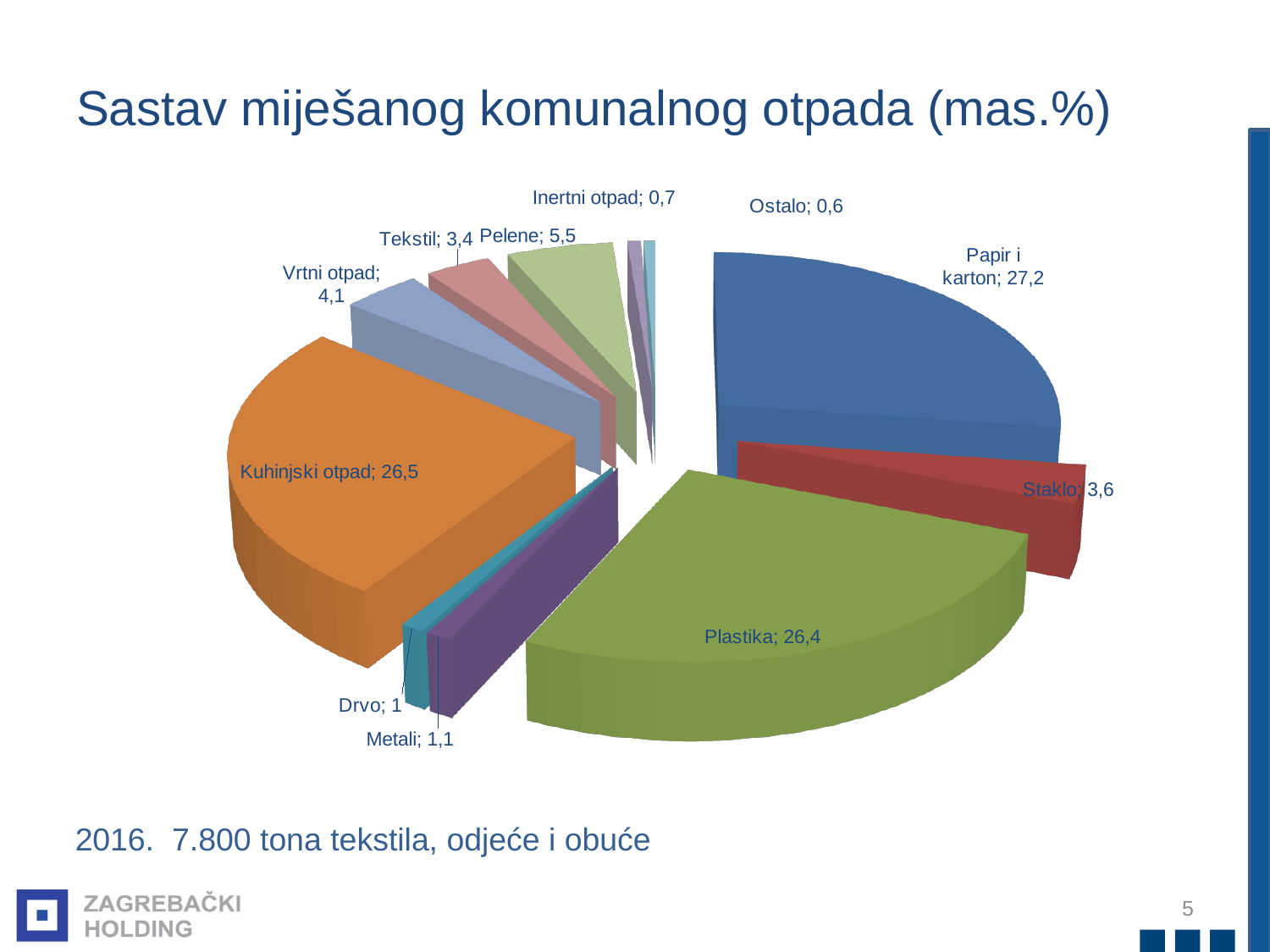
What kind of chart is shown on the slide? Pie chart What is the difference between the values for Papir i karton and Plastika? 0,8 What is the value for Pelene? 5,5 What is the value for Papir i karton? 27,2 Which category has the largest slice of the pie? Papir i karton What is the value for Kuhinjski otpad? 26,5 What is the title of the chart? Sastav miješanog komunalnog otpada (mas.%) Which is larger, the value for Vrtni otpad or the value for Staklo? Vrtni otpad How many categories are shown in the pie chart? 11 What is the difference between the values for Pelene and Tekstil? 2,1 Which category has the smallest slice of the pie? Ostalo What is the value for Drvo? 1